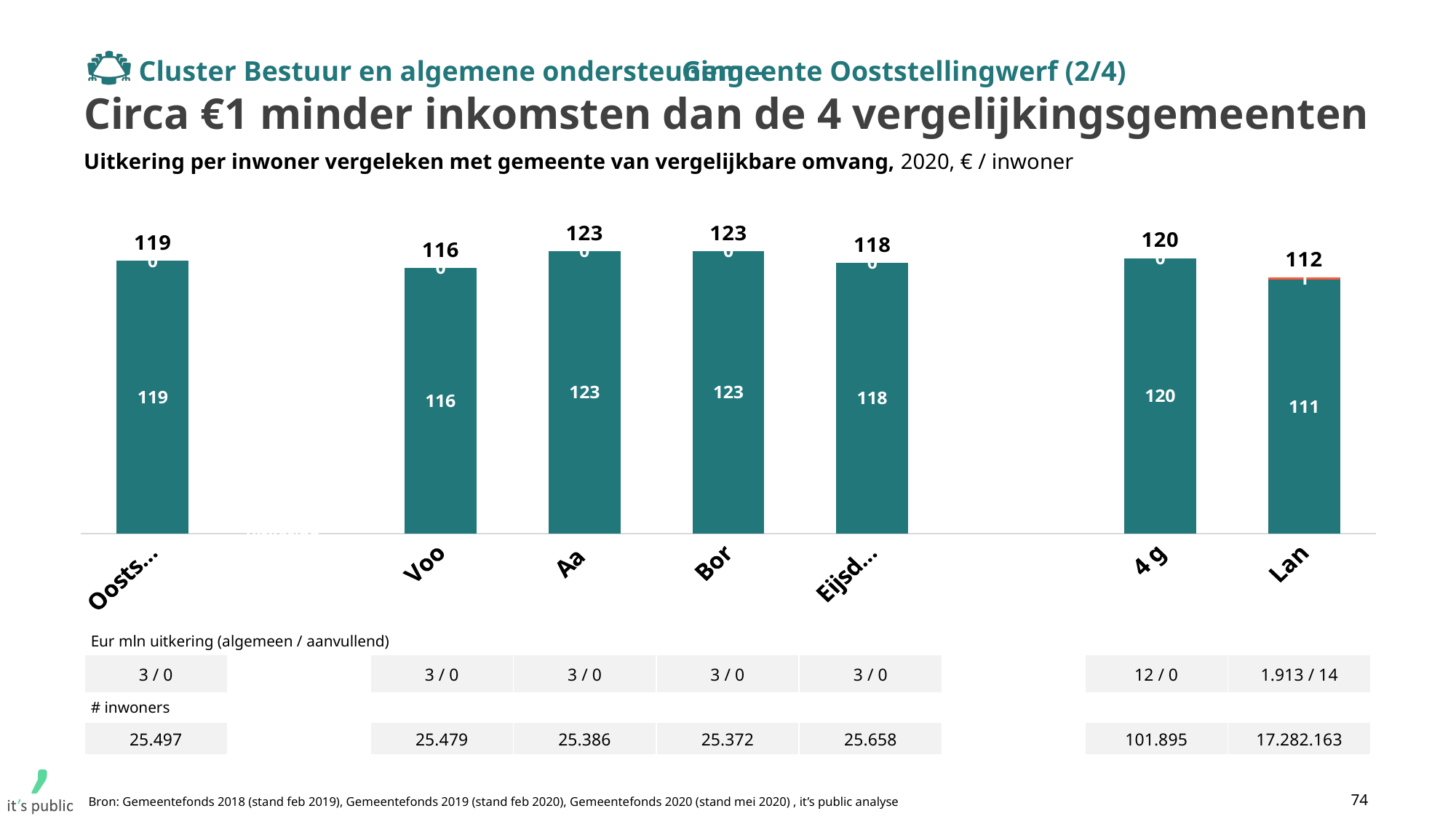
Which category has the lowest total value? Lan What is the value shown above the bar for Oosts…? 119 How many bars are plotted in the chart? 7 What is the total value shown above the stacked bar for Lan? 112 What kind of chart is shown on the slide? bar chart What is the difference between the total for Oosts… and the total for Lan? 7 What is the value shown above the bar for Voo? 116 What is the value shown above the bar for Eijsd…? 118 What is the value shown above the bar for 4 g? 120 What value is printed inside the large teal segment of the Lan bar? 111 What is the difference between the total for 4 g and the total for Oosts…? 1 Which is larger, the value for Voo or the value for Eijsd…? Eijsd…